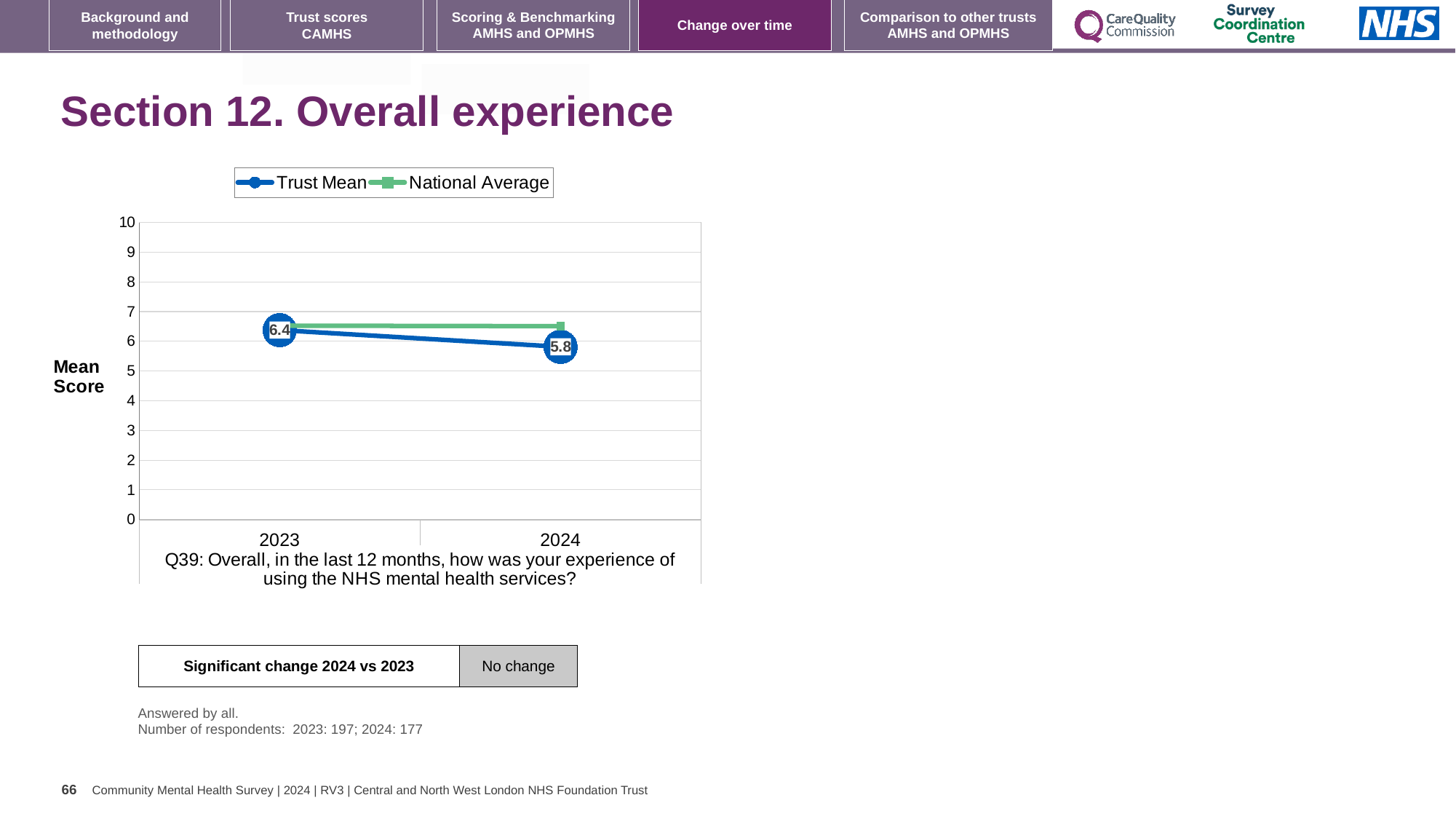
How many years are plotted on the x axis of the chart? 2 What type of chart is shown on the slide? line chart Is the National Average value for 2024 greater or less than 6? greater What is the Trust Mean score for 2023? 6.4 Which year has the higher Trust Mean score, 2023 or 2024? 2023 In 2024, which series has the higher value, Trust Mean or National Average? National Average Does the Trust Mean score rise or fall from 2023 to 2024? fall What is the Trust Mean score for 2024? 5.8 How many series does the chart legend list? 2 By how much did the Trust Mean score change from 2023 to 2024? 0.6 Is the Trust Mean value for 2024 greater or less than 6? less What is the label on the y axis of the chart? Mean Score